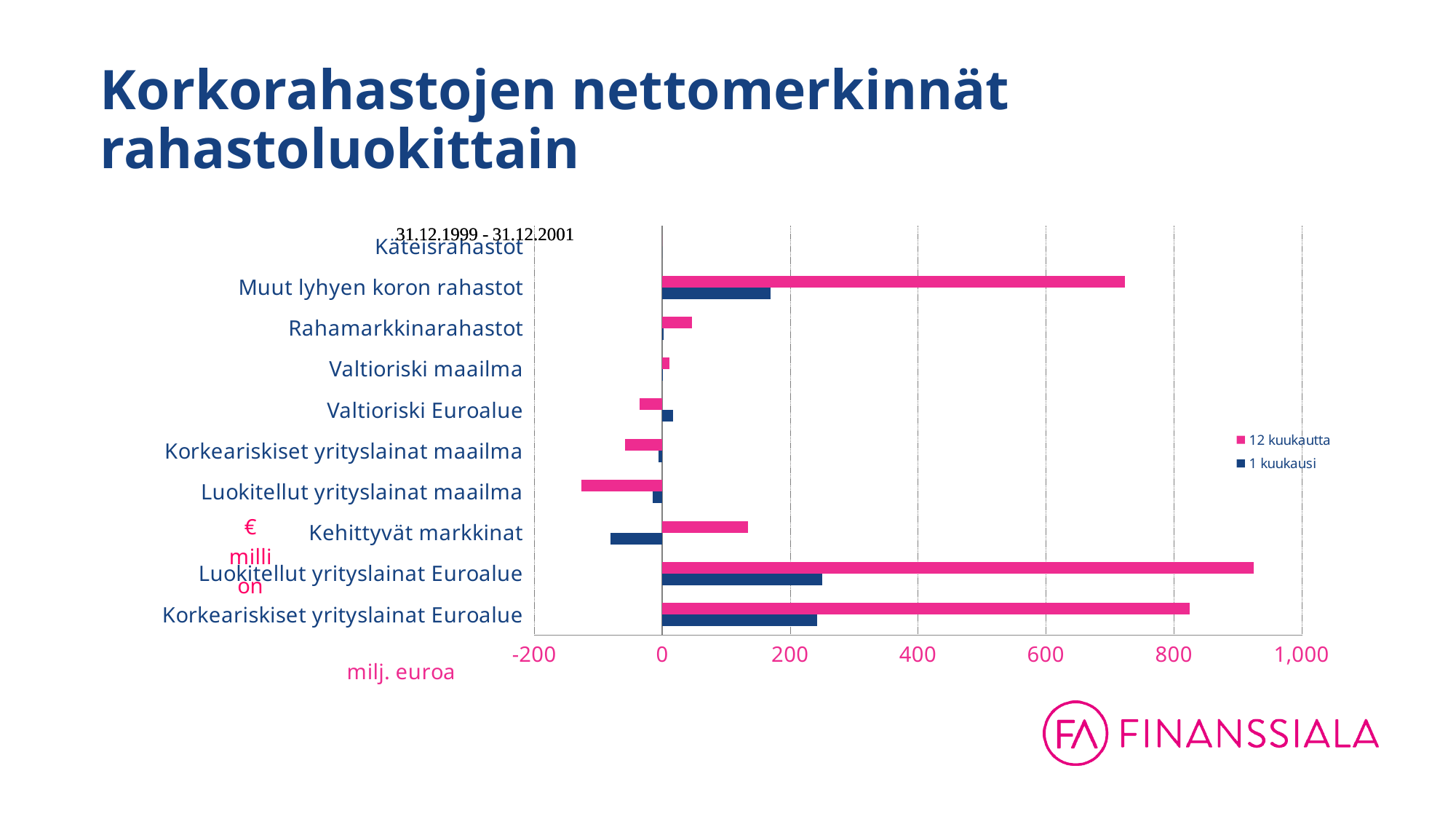
Is the 12 kuukautta value for Kehittyvät markkinat greater or less than 200? less Which has the larger 12 kuukautta value: Muut lyhyen koron rahastot or Kehittyvät markkinat? Muut lyhyen koron rahastot What kind of chart is shown on the slide? bar chart Which category has the lowest value for the 12 kuukautta series? Luokitellut yrityslainat maailma Which category has the lowest value for the 1 kuukausi series? Kehittyvät markkinat Which is larger for Kehittyvät markkinat: the 12 kuukautta value or the 1 kuukausi value? 12 kuukautta How many series does the legend list? 2 Is the 12 kuukautta value for Muut lyhyen koron rahastot greater or less than 600? greater Is the 1 kuukausi value for Korkeariskiset yrityslainat Euroalue greater or less than 200? greater Which category has the highest value for the 12 kuukautta series? Luokitellut yrityslainat Euroalue What unit is given for the x axis of the chart? milj. euroa How many fund categories are shown on the y axis? 10